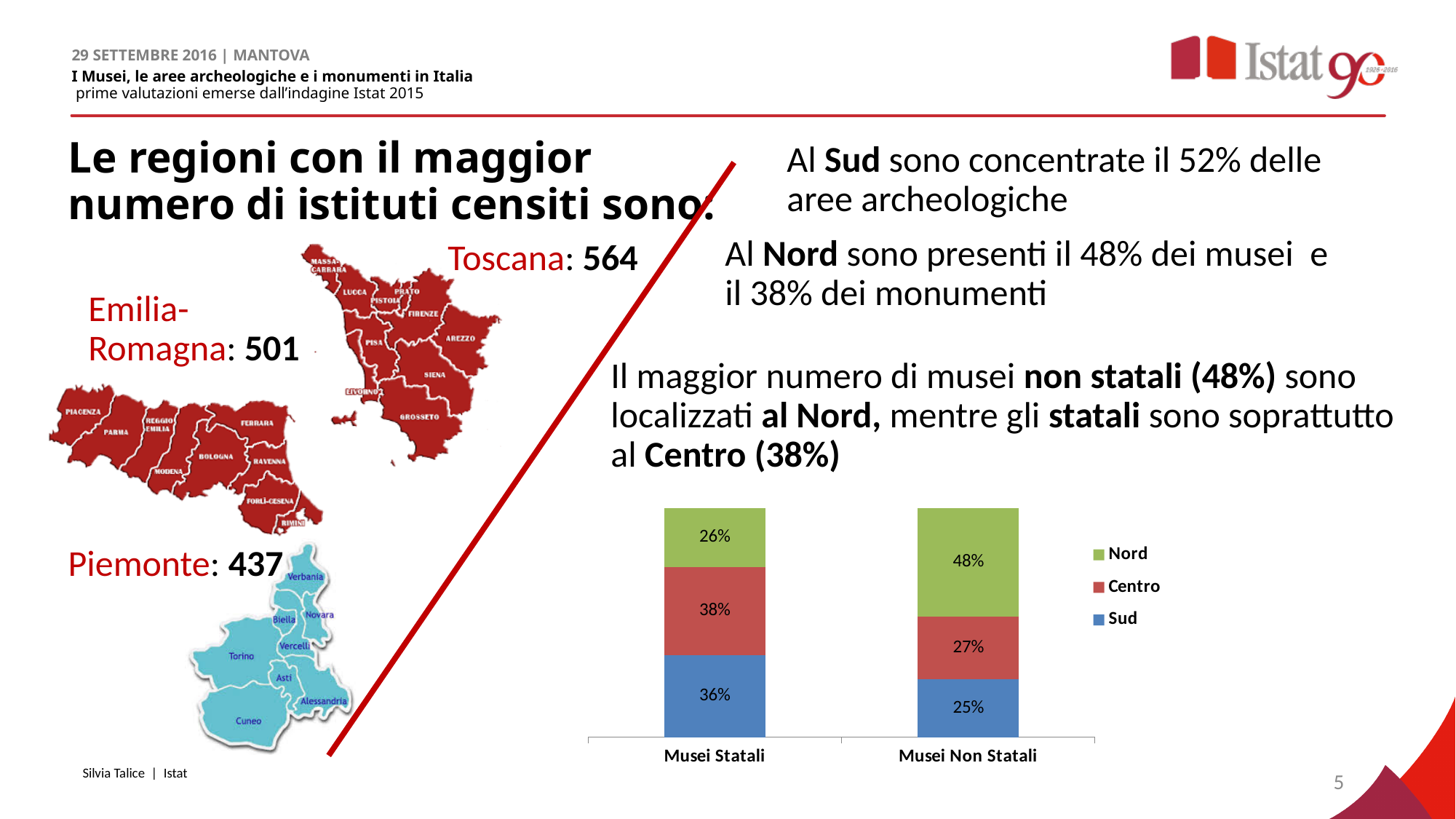
Which series has the smallest share in the Musei Statali bar? Nord How many series does the chart legend list? 3 What is the value for Centro in the Musei Statali bar? 38% What is the value for Sud in the Musei Statali bar? 36% What is the difference between the Nord value for Musei Non Statali and the Nord value for Musei Statali? 22 percentage points Which series has the largest share in the Musei Non Statali bar? Nord What is the value for Sud in the Musei Non Statali bar? 25% What is the value for Nord in the Musei Non Statali bar? 48% How many categories are shown on the x axis of the chart? 2 What kind of chart is shown on the slide? Stacked bar chart Which is larger: the Centro value for Musei Statali or the Centro value for Musei Non Statali? Musei Statali Which colour represents Sud in the chart? Blue